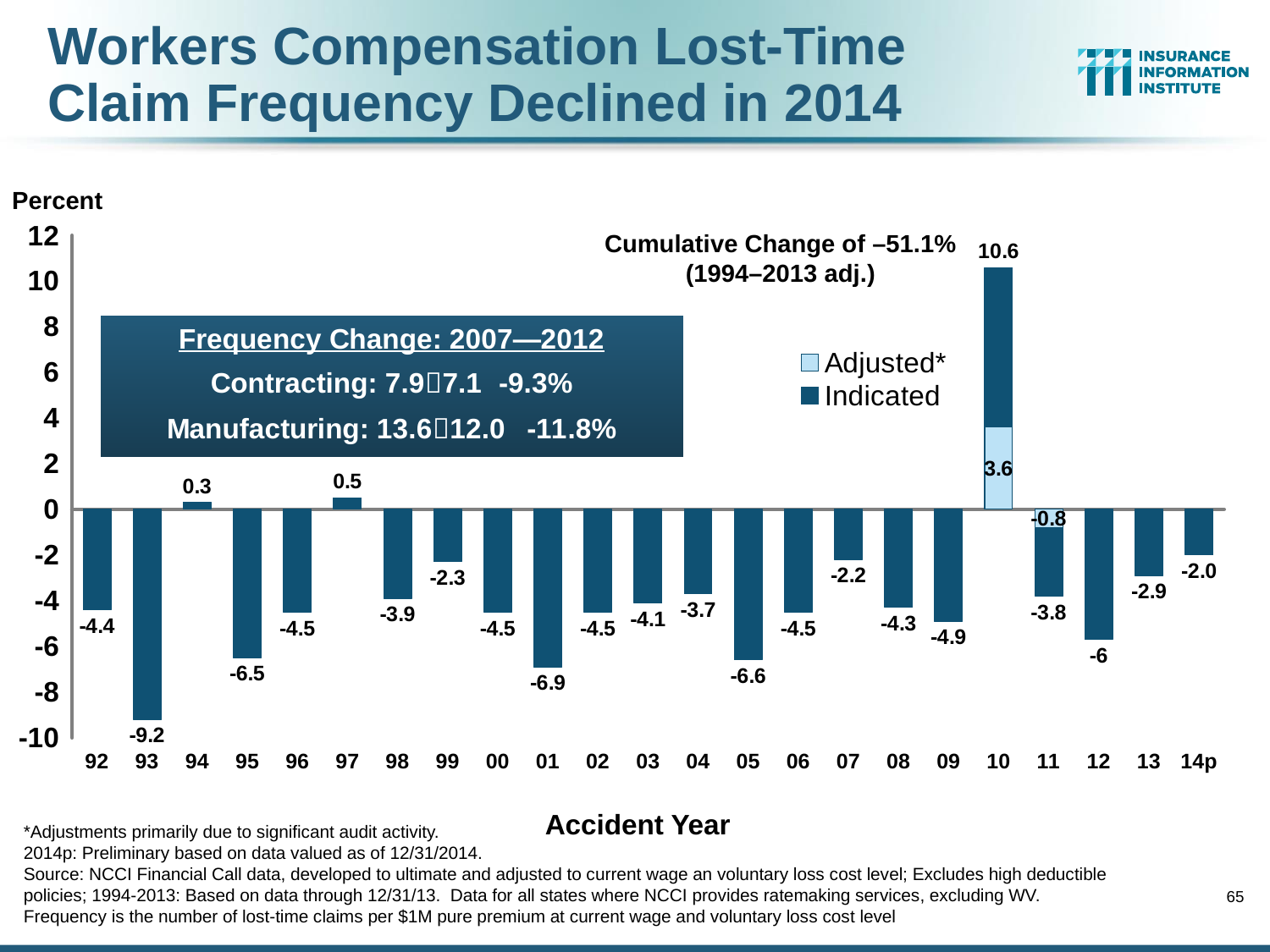
Which accident year has the highest value? 10 What is the Adjusted value for accident year 10? 3.6 How many accident years are shown on the x axis? 23 What is the cumulative change stated on the chart for 1994–2013 (adj.)? –51.1% Which is larger, the value for accident year 01 or accident year 05? 05 What kind of chart is shown on the slide? Bar chart What is the value for accident year 93? -9.2 What is the Indicated value for accident year 10? 10.6 What is the value for accident year 14p? -2.0 What is the difference between the values for accident years 12 and 13? 3.1 Which accident year has the lowest value? 93 How many series does the legend list? 2